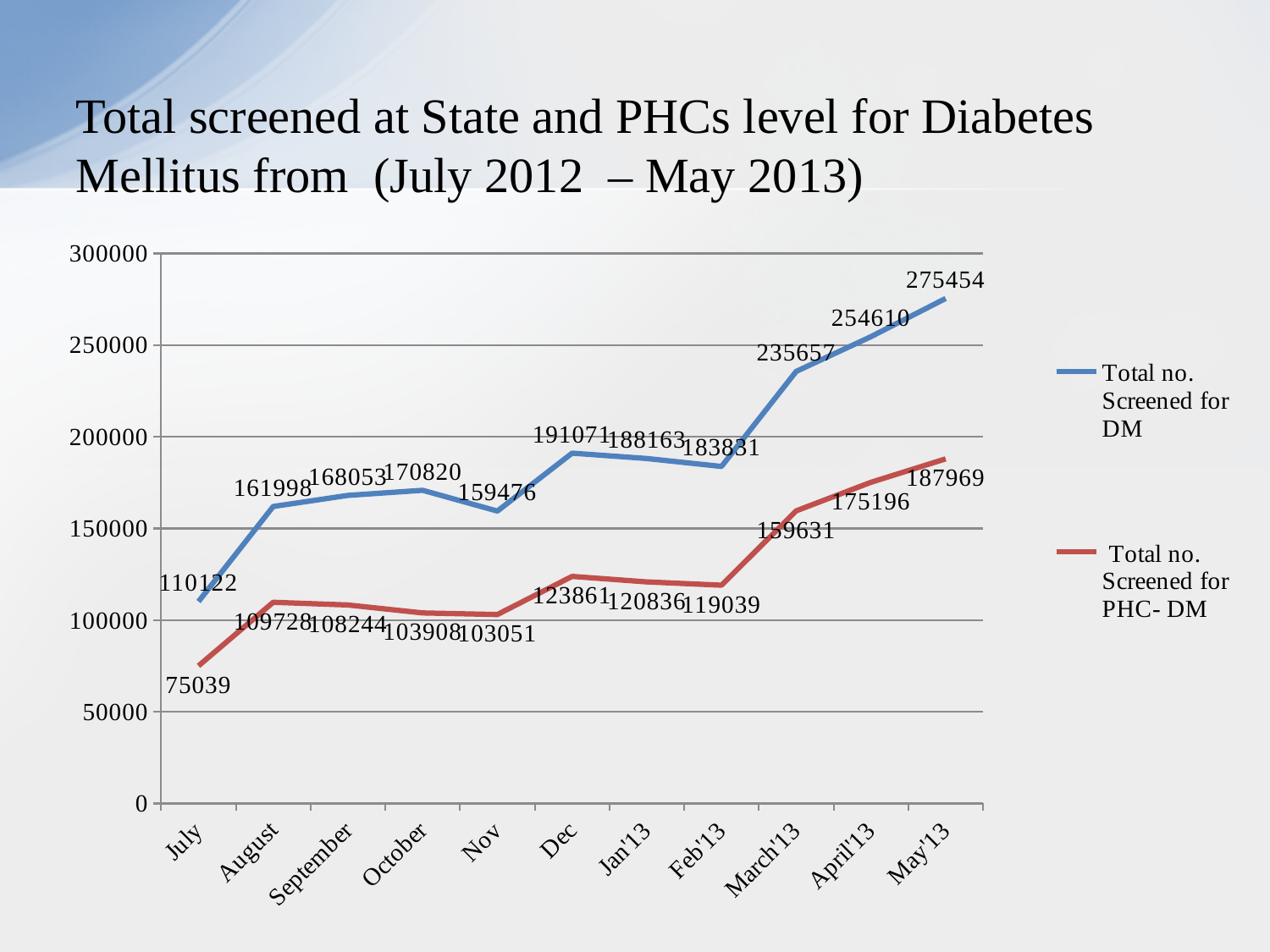
What is the value of Total no. Screened for PHC- DM in July? 75039 Is the value for Total no. Screened for DM in March'13 greater or less than 200000? greater How many series does the legend list? 2 How many months are shown on the x axis? 11 What is the difference between Total no. Screened for DM and Total no. Screened for PHC- DM in May'13? 87485 What kind of chart is shown on the slide? line chart What is the value of Total no. Screened for PHC- DM in Nov? 103051 In which month is Total no. Screened for DM highest? May'13 By how much did Total no. Screened for DM increase from July to August? 51876 Which month has a higher value for Total no. Screened for DM, Dec or Jan'13? Dec In which month is Total no. Screened for PHC- DM lowest? July What is the value of Total no. Screened for DM in May'13? 275454